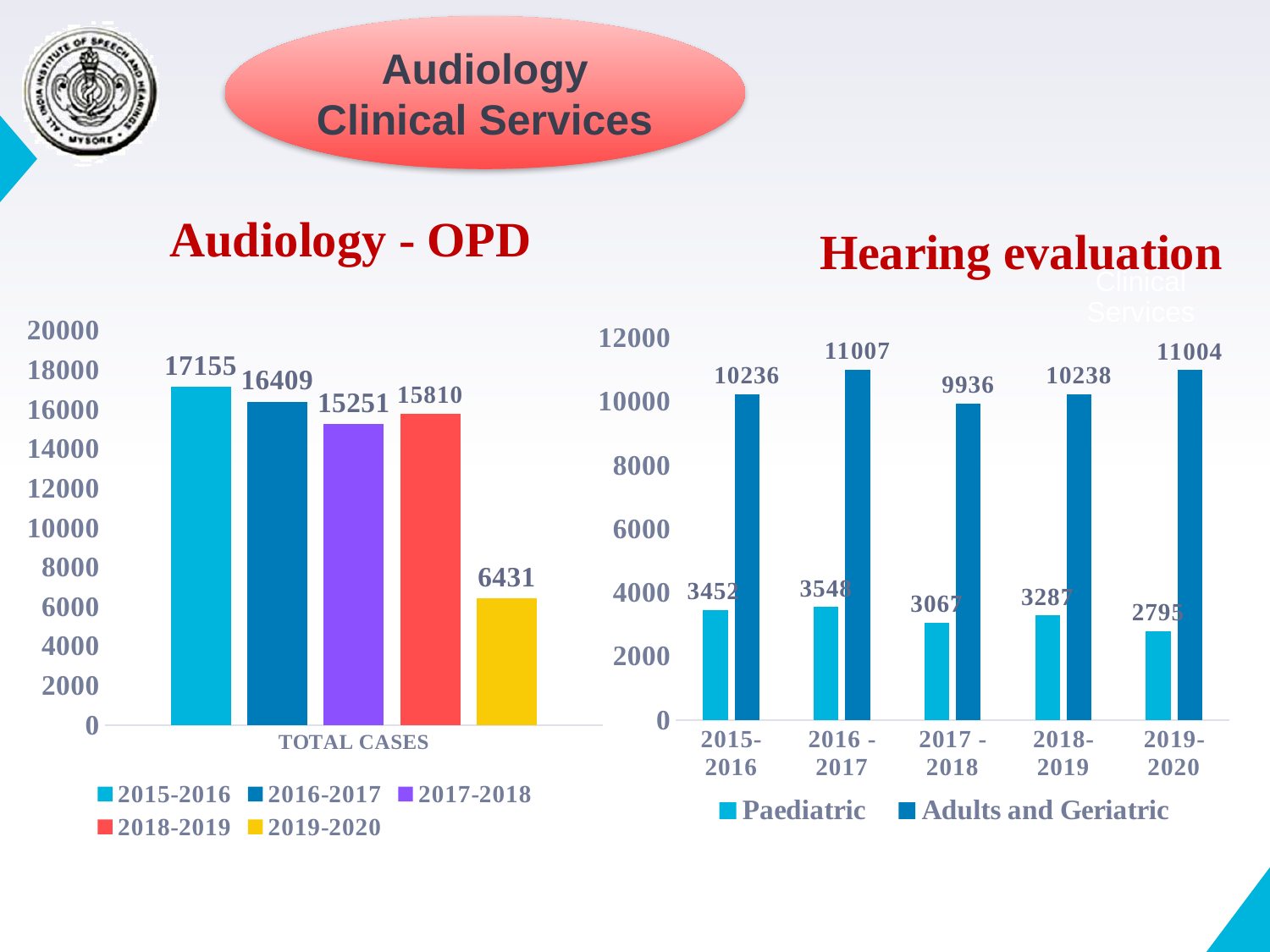
In the Hearing evaluation chart, which year has the highest Adults and Geriatric value? 2016-2017 In the Audiology - OPD chart, what is the difference between the 2016-2017 and 2017-2018 values? 1158 In the Audiology - OPD chart, which year has the lowest total cases? 2019-2020 In the Audiology - OPD chart, which year has the highest total cases? 2015-2016 In the Audiology - OPD chart, which is larger, the value for 2017-2018 or 2018-2019? 2018-2019 What kind of chart is the Hearing evaluation chart? Bar chart In the Hearing evaluation chart, what is the difference between the Adults and Geriatric and Paediatric values for 2015-2016? 6784 In the Hearing evaluation chart, how many years are shown on the x axis? 5 In the Hearing evaluation chart, what is the Adults and Geriatric value for 2017-2018? 9936 In the Audiology - OPD chart, how many series does the legend list? 5 In the Audiology - OPD chart, what is the value for 2015-2016? 17155 In the Hearing evaluation chart, what is the Paediatric value for 2019-2020? 2795